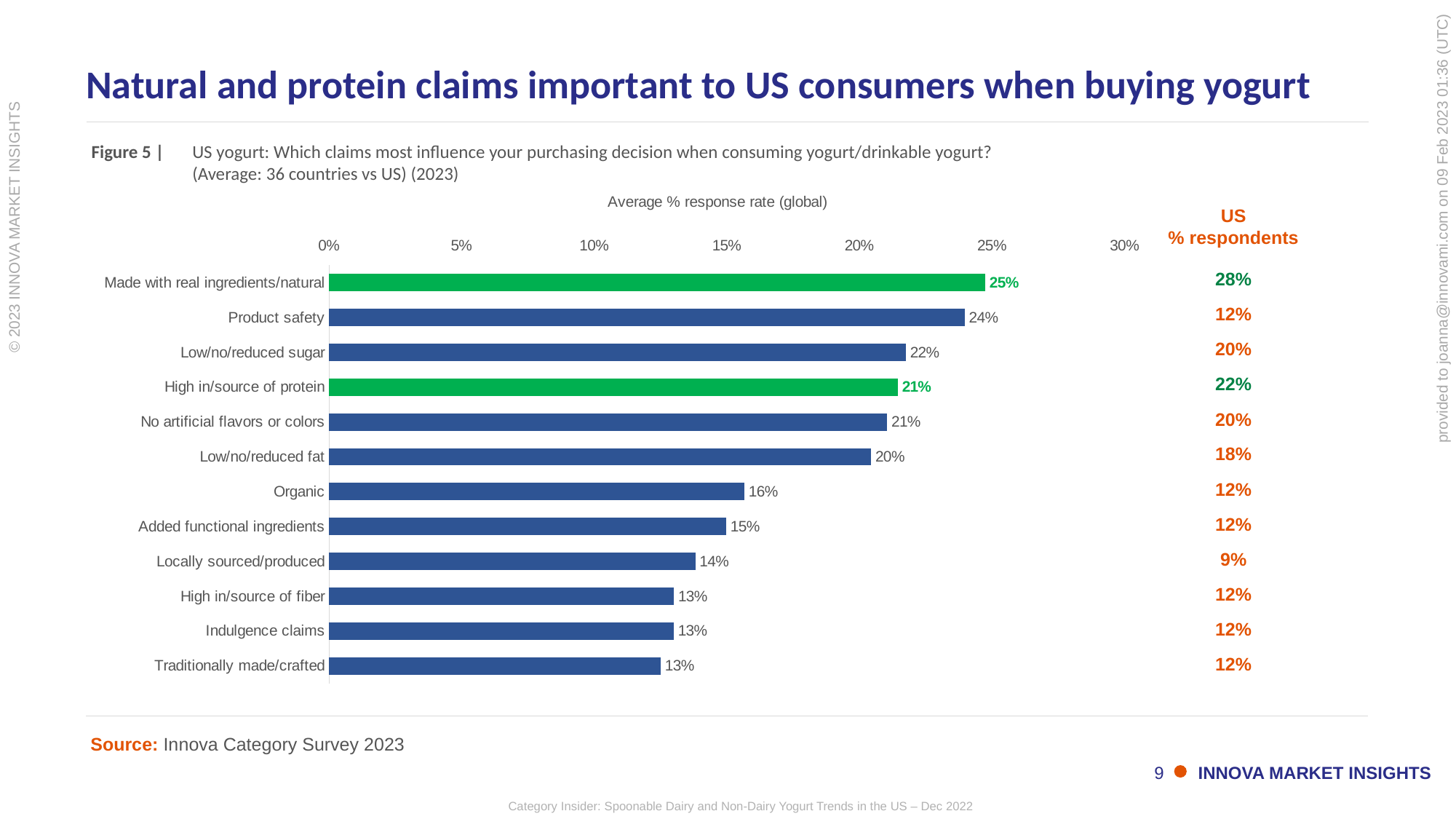
What is the average global % response rate for 'Low/no/reduced sugar'? 22% What is the US % respondents value for 'High in/source of protein'? 22% What is the average global % response rate for 'Made with real ingredients/natural'? 25% How many claims are listed in the chart? 12 What is the US % respondents value for 'Locally sourced/produced'? 9% Is the global average value for 'Organic' greater or less than 20%? less What type of chart is shown on the slide? Bar chart Which two claims are highlighted with green bars? Made with real ingredients/natural and High in/source of protein Which is larger for 'Made with real ingredients/natural': the global average or the US % respondents? US % respondents What is the difference between the global average and the US value for 'Product safety'? 12% Which claim has the highest average global % response rate? Made with real ingredients/natural Which claim has the lowest US % respondents value? Locally sourced/produced